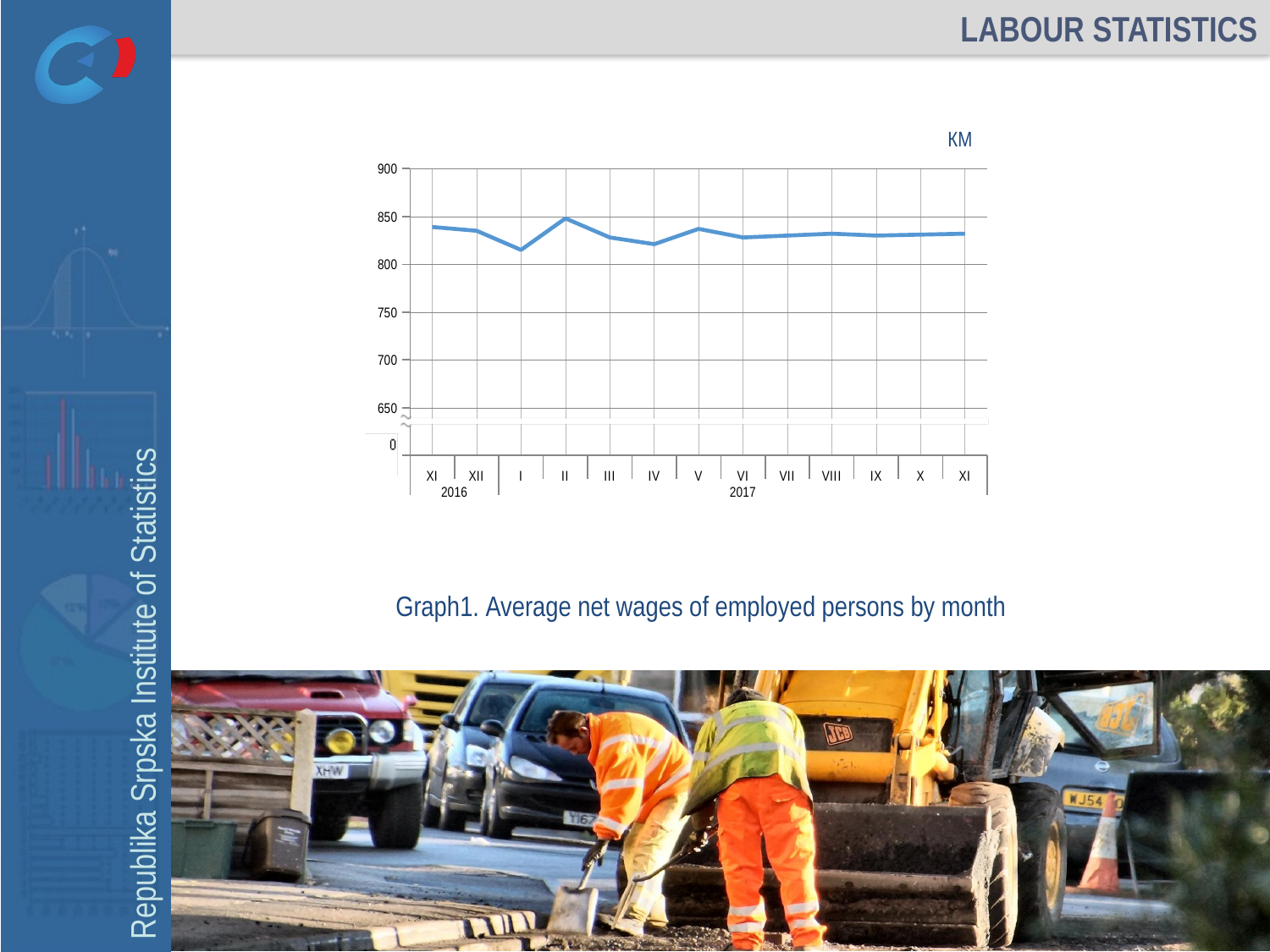
What is the title of the chart on the slide? Graph1. Average net wages of employed persons by month How many monthly data points are plotted on the chart? 13 Which month has the lowest average net wage on the chart? I 2017 Is the value for I 2017 greater or less than 800? greater Do the values rise or fall from XI 2016 to I 2017? fall Which month has the highest average net wage on the chart? II 2017 Is the value for I 2017 greater or less than 850? less Which is larger, the value for II 2017 or the value for I 2017? II 2017 What kind of chart is shown on the slide? line chart What unit is shown above the chart's vertical axis? KM Is the value for XI 2017 greater or less than 850? less Which is larger, the value for XI 2016 or the value for IV 2017? XI 2016